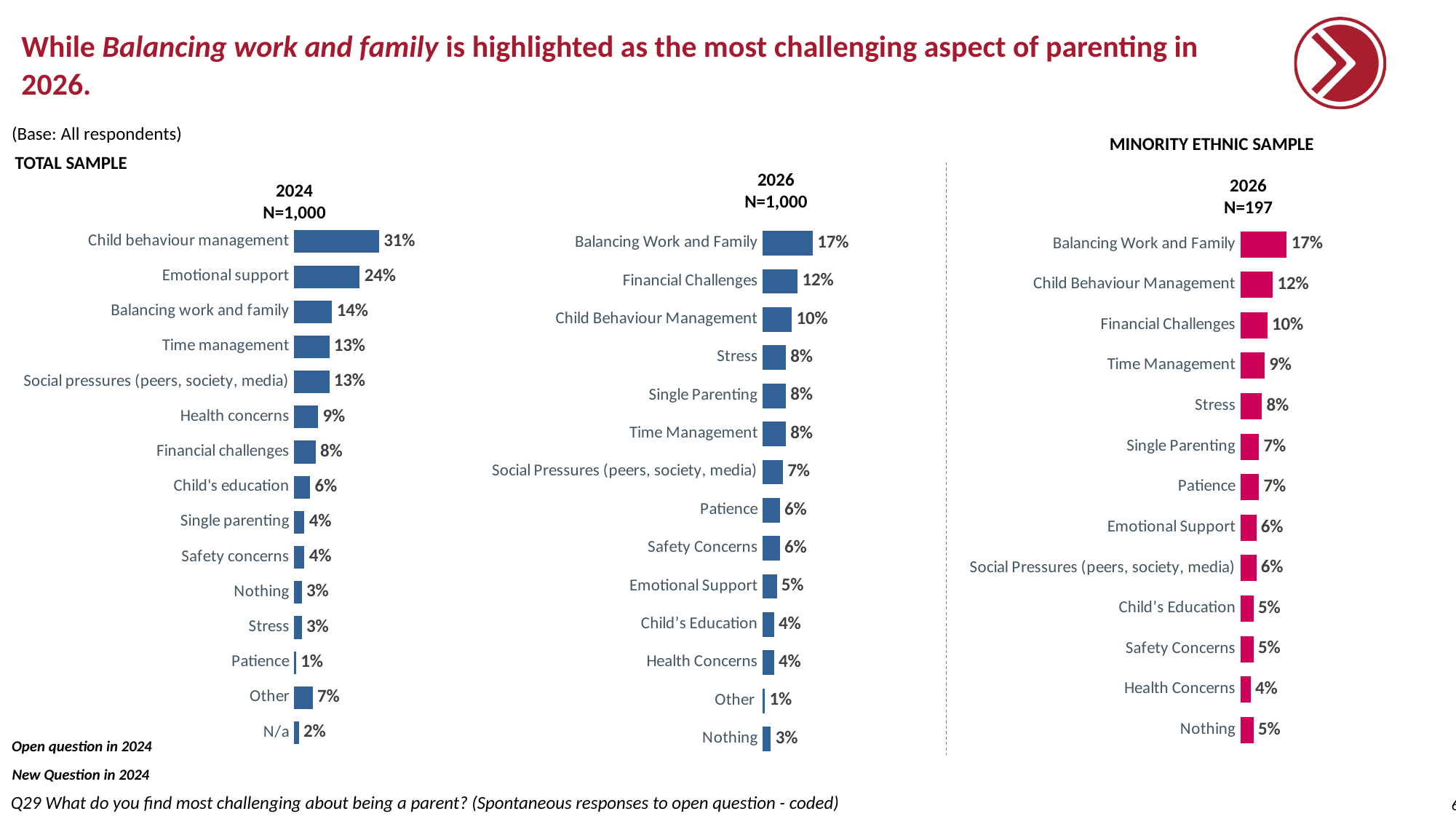
How many categories are shown in the 2026 Minority Ethnic Sample chart? 13 In the 2026 Minority Ethnic Sample chart, which is larger: Child Behaviour Management or Stress? Child Behaviour Management In the 2024 Total Sample chart, which category has the lowest value? Patience In the 2026 Total Sample chart, which category has the highest value? Balancing Work and Family In the 2026 Total Sample chart, what is the value for Financial Challenges? 12% In the 2026 Total Sample chart, what is the difference between Balancing Work and Family and Child Behaviour Management? 7% In the 2024 Total Sample chart, what is the difference between Child behaviour management and Emotional support? 7% In the 2026 Minority Ethnic Sample chart, what is the value for Time Management? 9% In the 2024 Total Sample chart, what is the value for Child behaviour management? 31% What type of chart is used for the 2026 Minority Ethnic Sample? Bar chart How many categories are shown in the 2024 Total Sample chart? 15 In the 2026 Minority Ethnic Sample chart, which category has the lowest value? Health Concerns